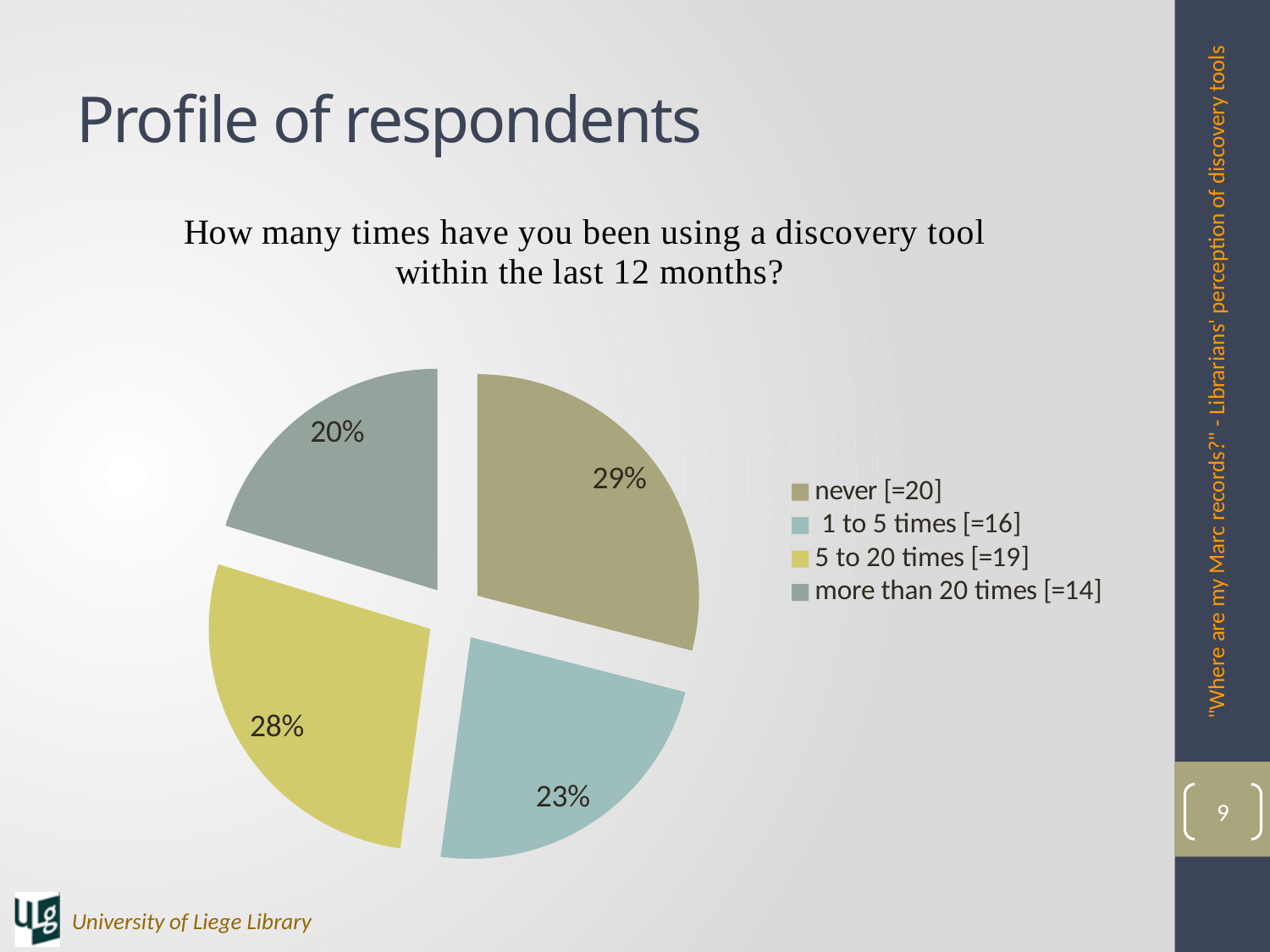
Which is larger, the share for "5 to 20 times" or the share for "1 to 5 times"? 5 to 20 times According to the legend, how many respondents answered "5 to 20 times"? 19 What percentage of respondents answered "1 to 5 times"? 23% How many slices does the pie chart have? 4 What percentage of respondents answered "more than 20 times"? 20% What is the difference in percentage points between the "never" slice and the "more than 20 times" slice? 9 What percentage of respondents answered "5 to 20 times"? 28% What percentage of respondents answered "never"? 29% What kind of chart is shown on the slide? pie chart Which response category has the largest share of the pie? never What question is the pie chart about, as stated above it? How many times have you been using a discovery tool within the last 12 months? Which response category has the smallest share of the pie? more than 20 times